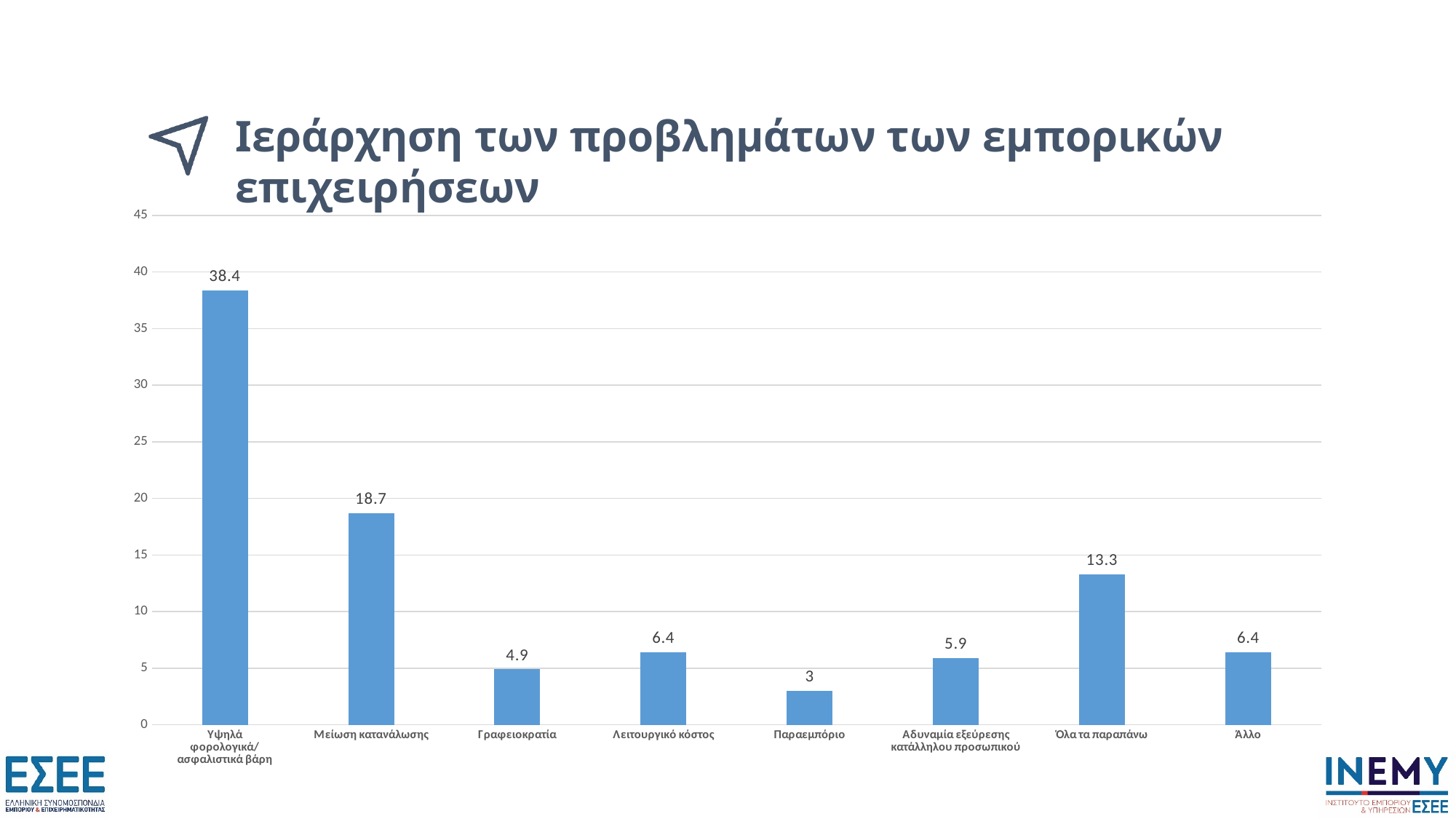
Which category has the highest value? Υψηλά φορολογικά/ασφαλιστικά βάρη What is the value for Μείωση κατανάλωσης? 18.7 Which is larger, the value for Γραφειοκρατία or the value for Λειτουργικό κόστος? Λειτουργικό κόστος What is the value for Αδυναμία εξεύρεσης κατάλληλου προσωπικού? 5.9 What is the value for Παραεμπόριο? 3 Which category has the lowest value? Παραεμπόριο What kind of chart is shown on the slide? bar chart What is the difference between the values for Υψηλά φορολογικά/ασφαλιστικά βάρη and Μείωση κατανάλωσης? 19.7 What is the title of the slide? Ιεράρχηση των προβλημάτων των εμπορικών επιχειρήσεων Is the value for Όλα τα παραπάνω greater or less than 10? greater What is the value for Όλα τα παραπάνω? 13.3 How many categories are shown on the x axis? 8